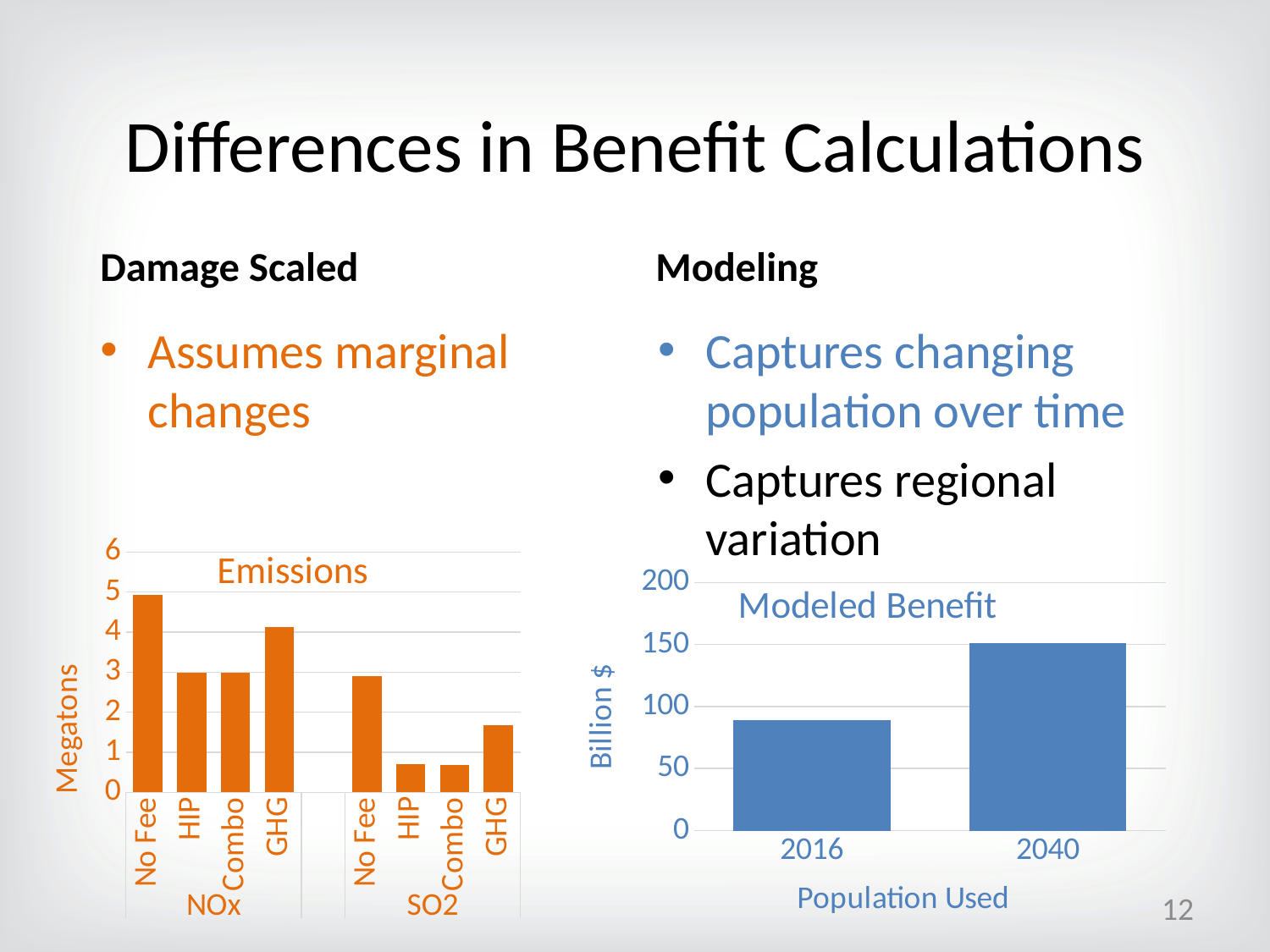
In the Emissions chart, is the value for HIP under SO2 greater or less than 1? less How many bars are plotted in the Emissions chart? 8 In the Emissions chart, is the value for GHG under NOx greater or less than 3? greater In the Modeled Benefit chart, is the value for 2016 greater or less than 100? less In the Emissions chart, which is larger: GHG under SO2 or HIP under SO2? GHG under SO2 In the Emissions chart, which is larger: No Fee under NOx or No Fee under SO2? No Fee under NOx In the Modeled Benefit chart, which category has the higher value? 2040 What kind of chart is the Emissions chart? bar chart In the Emissions chart, which bar is the highest? No Fee (NOx) What is the y-axis label of the Emissions chart? Megatons In the Modeled Benefit chart, do the values rise or fall from 2016 to 2040? rise